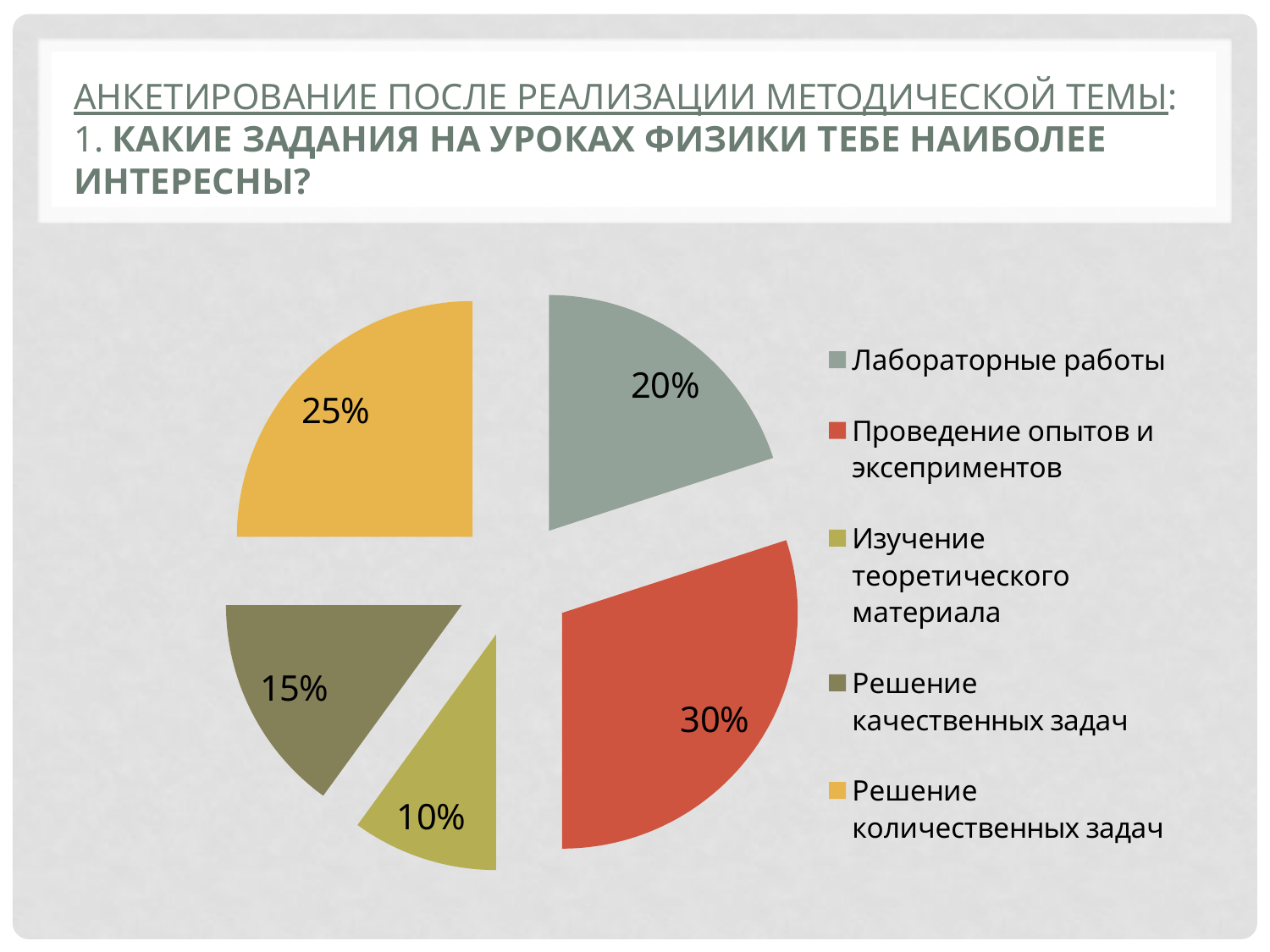
What percentage is shown for "Изучение теоретического материала"? 10% Which category has the largest slice of the pie? Проведение опытов и эксеприментов What is the difference in percentage points between "Проведение опытов и эксеприментов" and "Лабораторные работы"? 10% What share of the pie is labelled for "Лабораторные работы"? 20% Which category has the smallest slice of the pie? Изучение теоретического материала What kind of chart is shown on the slide? pie chart How many categories does the legend list? 5 What percentage is shown for "Проведение опытов и эксеприментов"? 30% What percentage is shown for "Решение качественных задач"? 15% What percentage is shown for "Решение количественных задач"? 25% What colour is the slice for "Решение количественных задач"? yellow Which is larger: the slice for "Решение количественных задач" or the slice for "Решение качественных задач"? Решение количественных задач